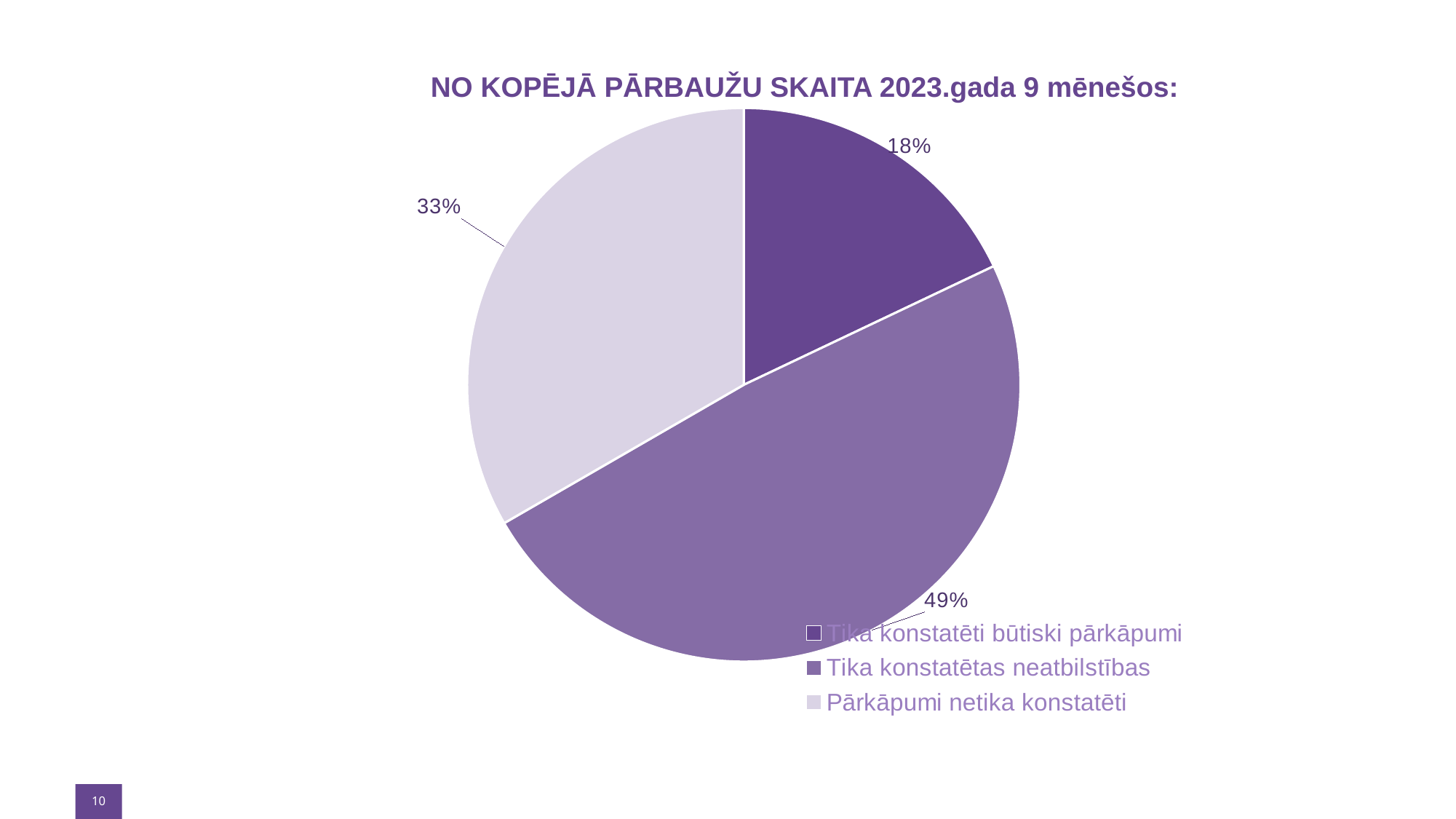
How many entries does the legend list? 3 What share of the pie is labelled for 'Pārkāpumi netika konstatēti'? 33% How many slices does the pie chart have? 3 What is the largest percentage shown on the pie chart? 49% What type of chart is shown on the slide? pie chart What share of the pie is labelled for 'Tika konstatētas neatbilstības'? 49% What is the smallest percentage shown on the pie chart? 18% What is the difference in percentage points between 'Pārkāpumi netika konstatēti' and 'Tika konstatētas neatbilstības'? 16 What is the difference in percentage points between the largest slice (49%) and the smallest slice (18%)? 31 What is the total of the three percentages shown on the pie chart? 100% Which is larger: the share for 'Pārkāpumi netika konstatēti' or the share for 'Tika konstatētas neatbilstības'? Tika konstatētas neatbilstības What is the title of the chart? NO KOPĒJĀ PĀRBAUŽU SKAITA 2023.gada 9 mēnešos: